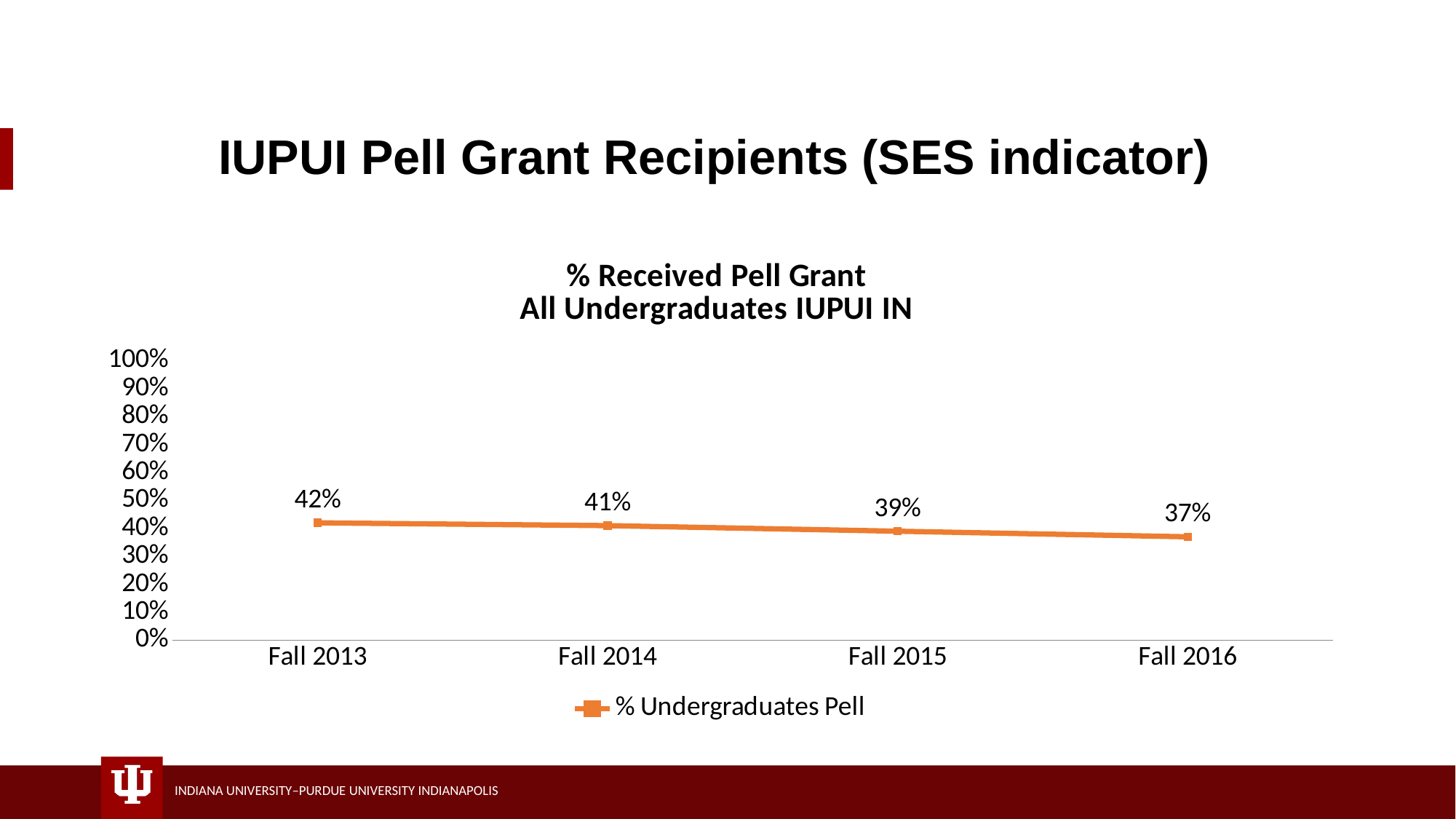
Do the values rise or fall from Fall 2013 to Fall 2016? fall What is the value for Fall 2014? 41% What is the difference between the Fall 2013 and Fall 2016 values? 5% How many terms are plotted on the x axis? 4 What percentage of undergraduates received a Pell Grant in Fall 2013? 42% Which term has the highest percentage of undergraduates receiving a Pell Grant? Fall 2013 What is the value for Fall 2015? 39% Is the value for Fall 2016 greater or less than 40%? less What is the value for Fall 2016? 37% What kind of chart is shown on the slide? line chart Which term has the lowest percentage of undergraduates receiving a Pell Grant? Fall 2016 Which is larger, the value for Fall 2014 or the value for Fall 2015? Fall 2014